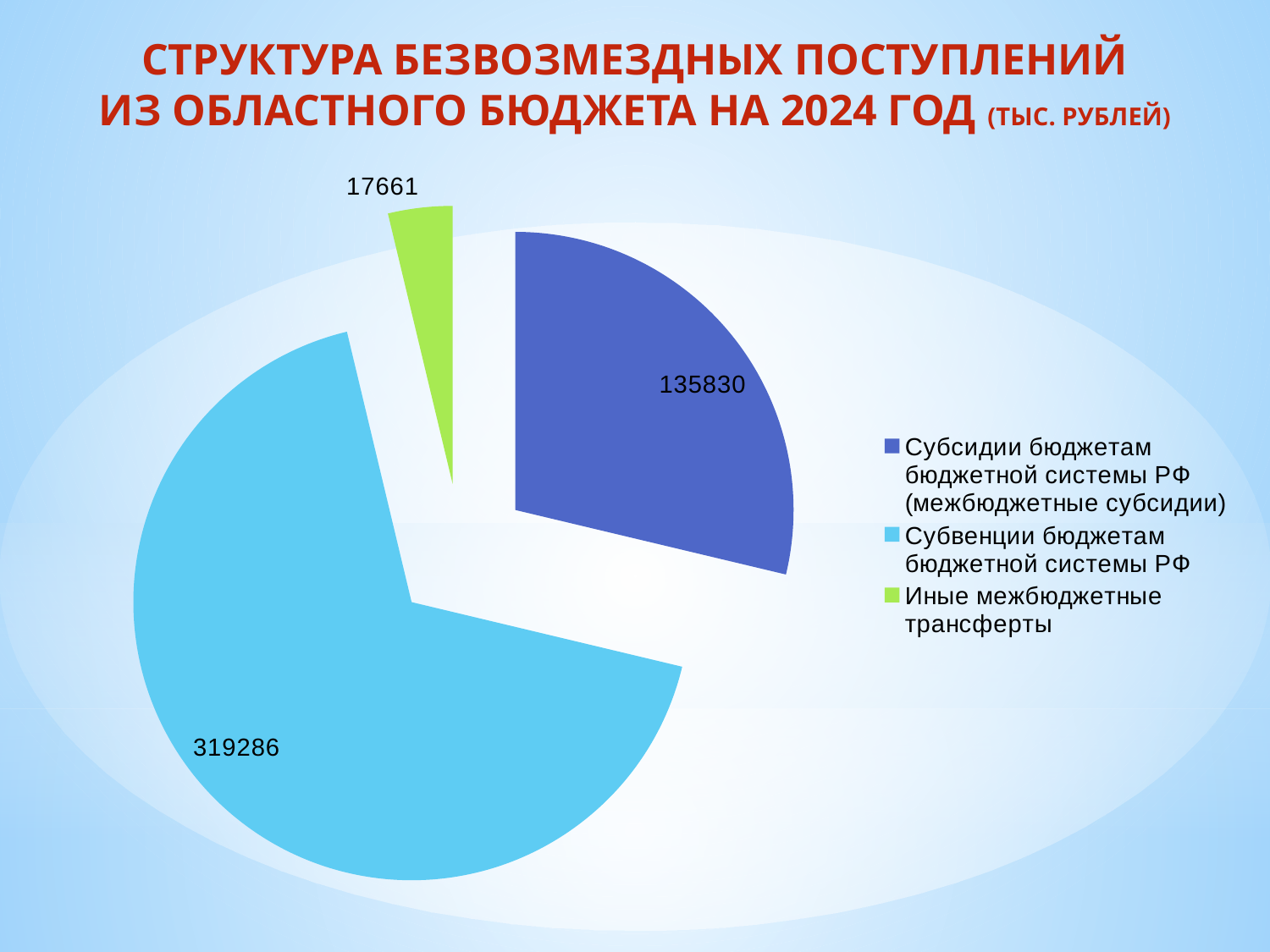
What colour is the slice for Иные межбюджетные трансферты? Green What is the difference between the value for Субвенции бюджетам бюджетной системы РФ and the value for Субсидии бюджетам бюджетной системы РФ (межбюджетные субсидии)? 183456 What is the difference between the value for Субсидии бюджетам бюджетной системы РФ (межбюджетные субсидии) and the value for Иные межбюджетные трансферты? 118169 What is the value for Субсидии бюджетам бюджетной системы РФ (межбюджетные субсидии)? 135830 What is the value for Иные межбюджетные трансферты? 17661 What is the value for Субвенции бюджетам бюджетной системы РФ? 319286 Which is larger: the value for Субсидии бюджетам бюджетной системы РФ (межбюджетные субсидии) or the value for Иные межбюджетные трансферты? Субсидии бюджетам бюджетной системы РФ (межбюджетные субсидии) Which category has the largest slice of the pie? Субвенции бюджетам бюджетной системы РФ What is the total of all three slices in the pie chart? 472777 What type of chart is shown on the slide? Pie chart Which category has the smallest slice of the pie? Иные межбюджетные трансферты How many slices does the pie chart have? 3